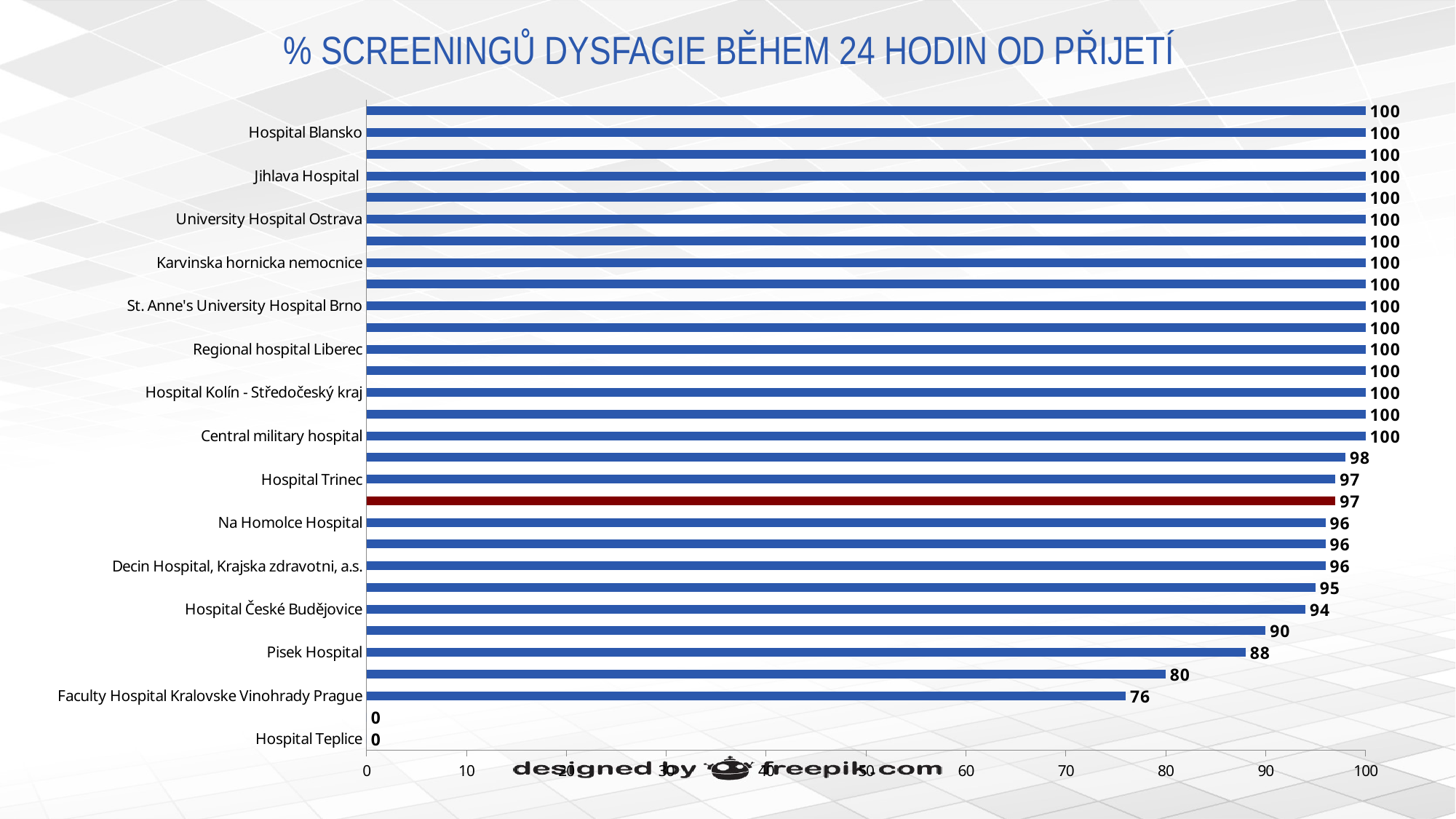
Is the value for Faculty Hospital Kralovske Vinohrady Prague greater or less than 80? less What is the value for Na Homolce Hospital? 96 Which labeled hospital has the lowest value? Hospital Teplice What is the value for Hospital České Budějovice? 94 What is the value for Faculty Hospital Kralovske Vinohrady Prague? 76 What is the value for Pisek Hospital? 88 What is the value for Hospital Trinec? 97 Which is larger, the value for Decin Hospital, Krajska zdravotni, a.s. or the value for Pisek Hospital? Decin Hospital, Krajska zdravotni, a.s. What is the difference between the values for Hospital České Budějovice and Faculty Hospital Kralovske Vinohrady Prague? 18 What is the difference between the values for Hospital Trinec and Pisek Hospital? 9 What value is shown next to the red bar? 97 What kind of chart is shown on the slide? bar chart